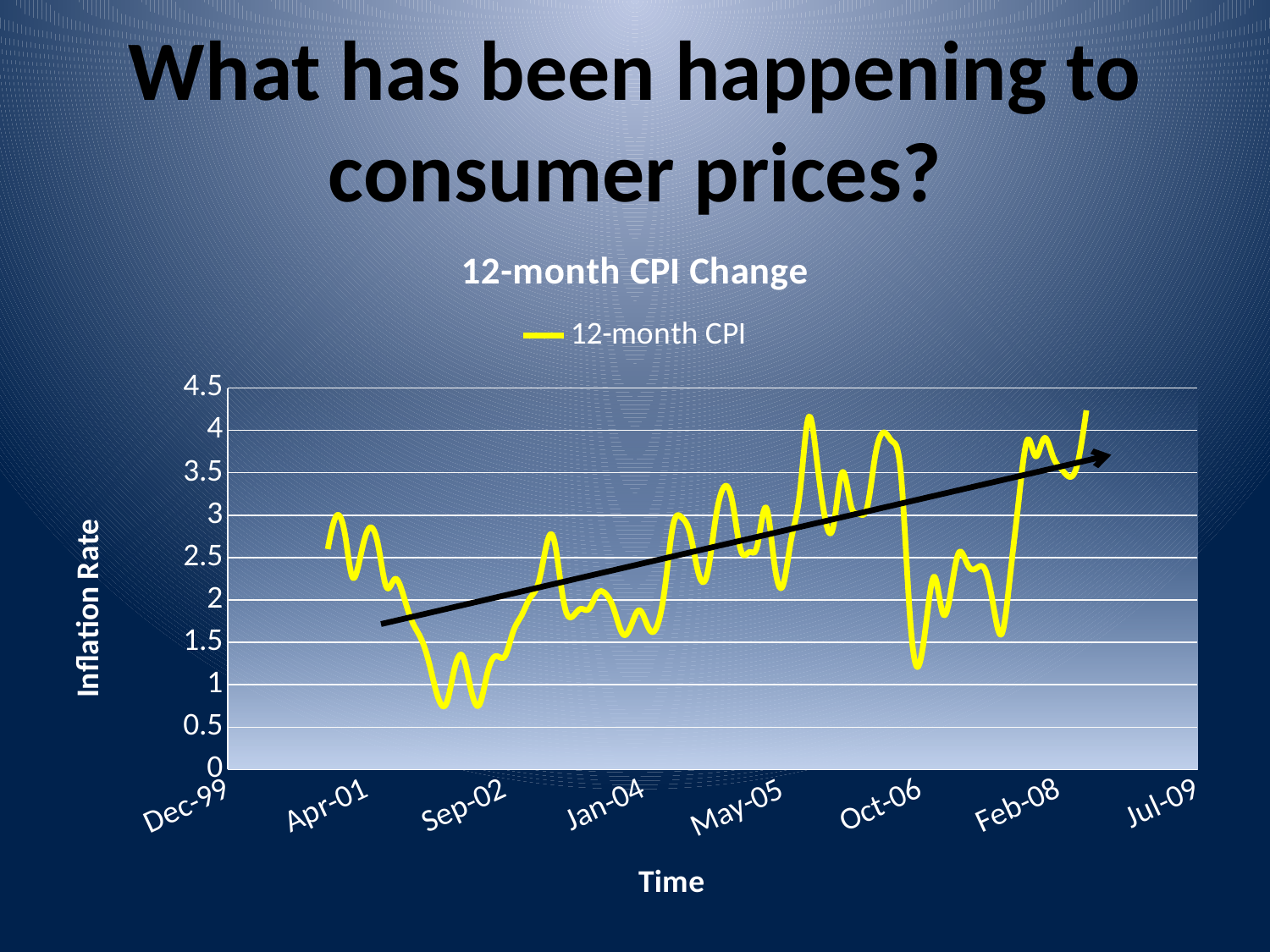
What is the title of the chart? 12-month CPI Change How many date labels are shown on the x axis? 8 Is the value of the 12-month CPI line around Sep-02 greater or less than 1.5? less Is the value of the 12-month CPI line just after Apr-01 greater or less than 2? greater What is the highest tick value shown on the y axis? 4.5 What is the label of the series in the legend? 12-month CPI Is the value of the 12-month CPI line around Sep-02 larger or smaller than the value just after Apr-01? smaller Is the lowest value of the 12-month CPI line greater or less than 1? less How many series does the legend list? 1 Overall, do the values of the 12-month CPI line rise or fall from Dec-99 to Jul-09? rise What kind of chart is shown on the slide? line chart